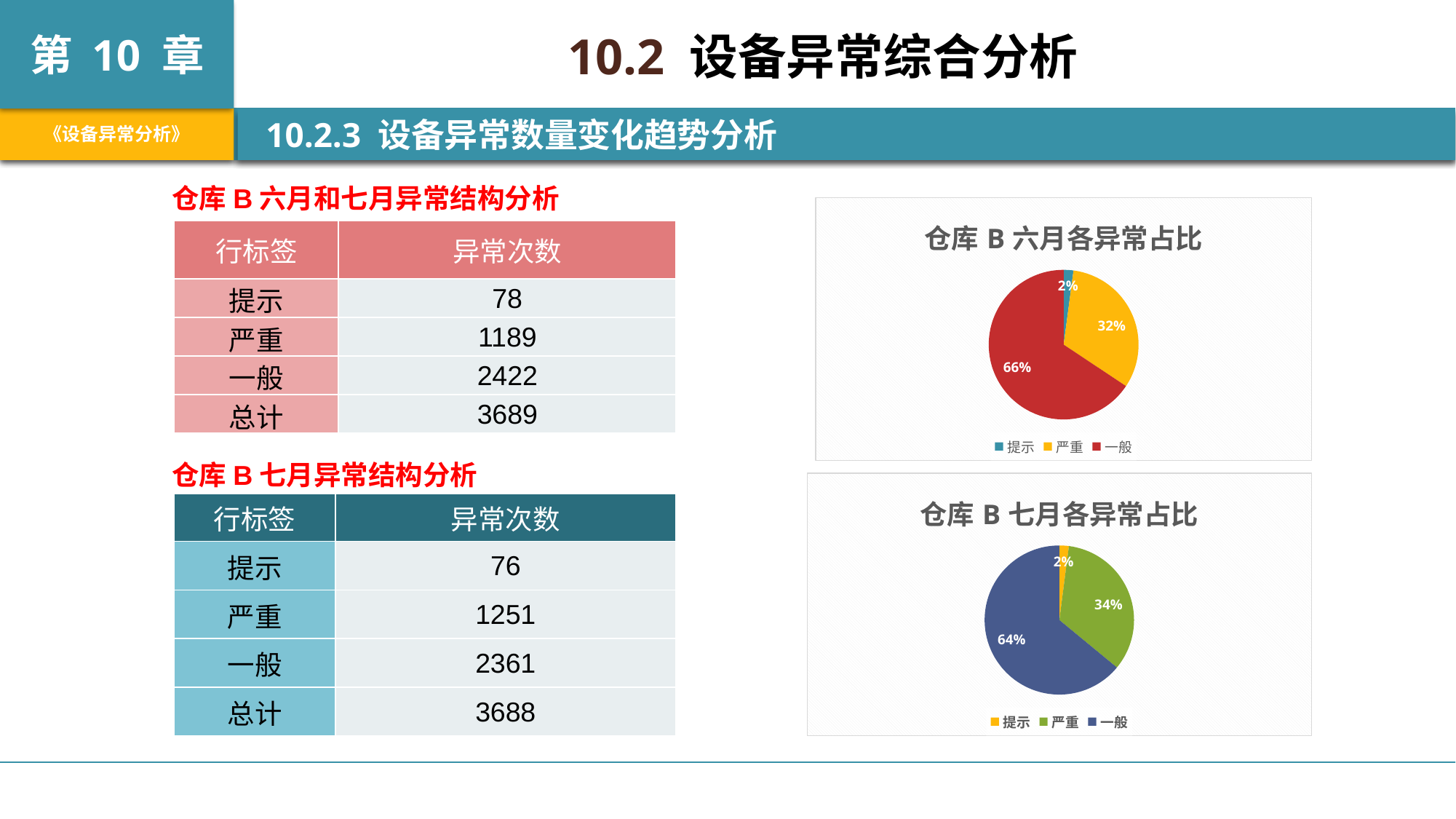
In the chart titled 仓库 B 六月各异常占比, what share of the pie does 严重 take? 32% In the chart titled 仓库 B 六月各异常占比, what share of the pie does 提示 take? 2% In the chart titled 仓库 B 六月各异常占比, which category has the smallest slice? 提示 In the chart titled 仓库 B 七月各异常占比, what share of the pie does 一般 take? 64% In the chart titled 仓库 B 六月各异常占比, which slice is larger, 严重 or 提示? 严重 In the chart titled 仓库 B 七月各异常占比, what colour is the 一般 slice? blue What kind of chart is 仓库 B 七月各异常占比? pie chart In the chart titled 仓库 B 七月各异常占比, which category has the largest slice? 一般 How many entries does the legend of the chart titled 仓库 B 六月各异常占比 list? 3 In the chart titled 仓库 B 七月各异常占比, what is the difference in percentage points between the 一般 slice and the 严重 slice? 30